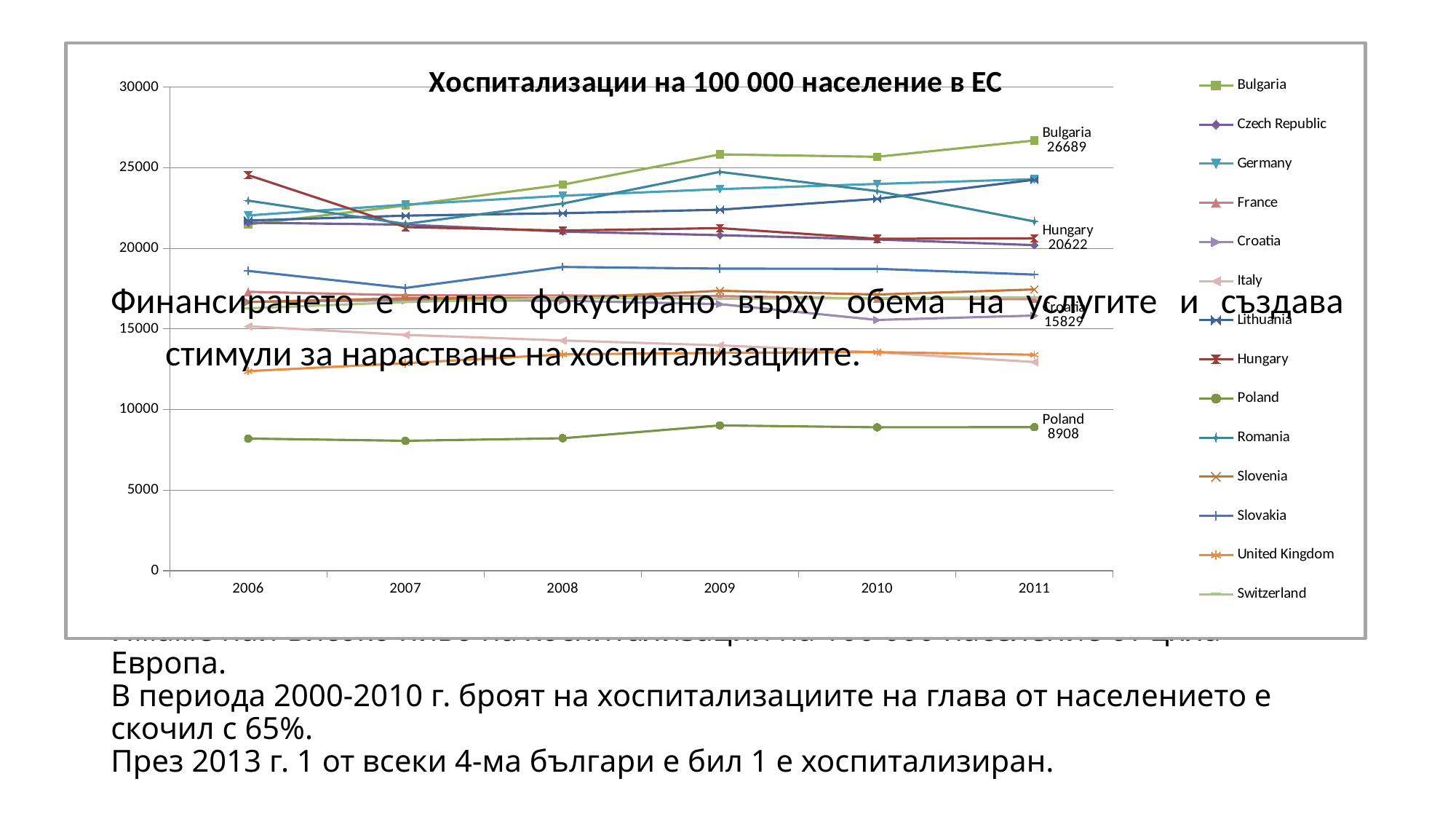
How many series does the legend list? 14 What is the title of the chart? Хоспитализации на 100 000 население в ЕС What is the value for Croatia in 2011? 15829 What is the value for Hungary in 2011? 20622 What is the difference between the 2011 values for Bulgaria and Poland? 17781 Is the value for Poland in 2006 greater or less than 10000? less Which country has the highest value in 2011? Bulgaria What is the value for Poland in 2011? 8908 What is the value for Bulgaria in 2011? 26689 What kind of chart is shown on the slide? line chart Which country has the lowest value in 2011? Poland How many years are shown on the x axis? 6